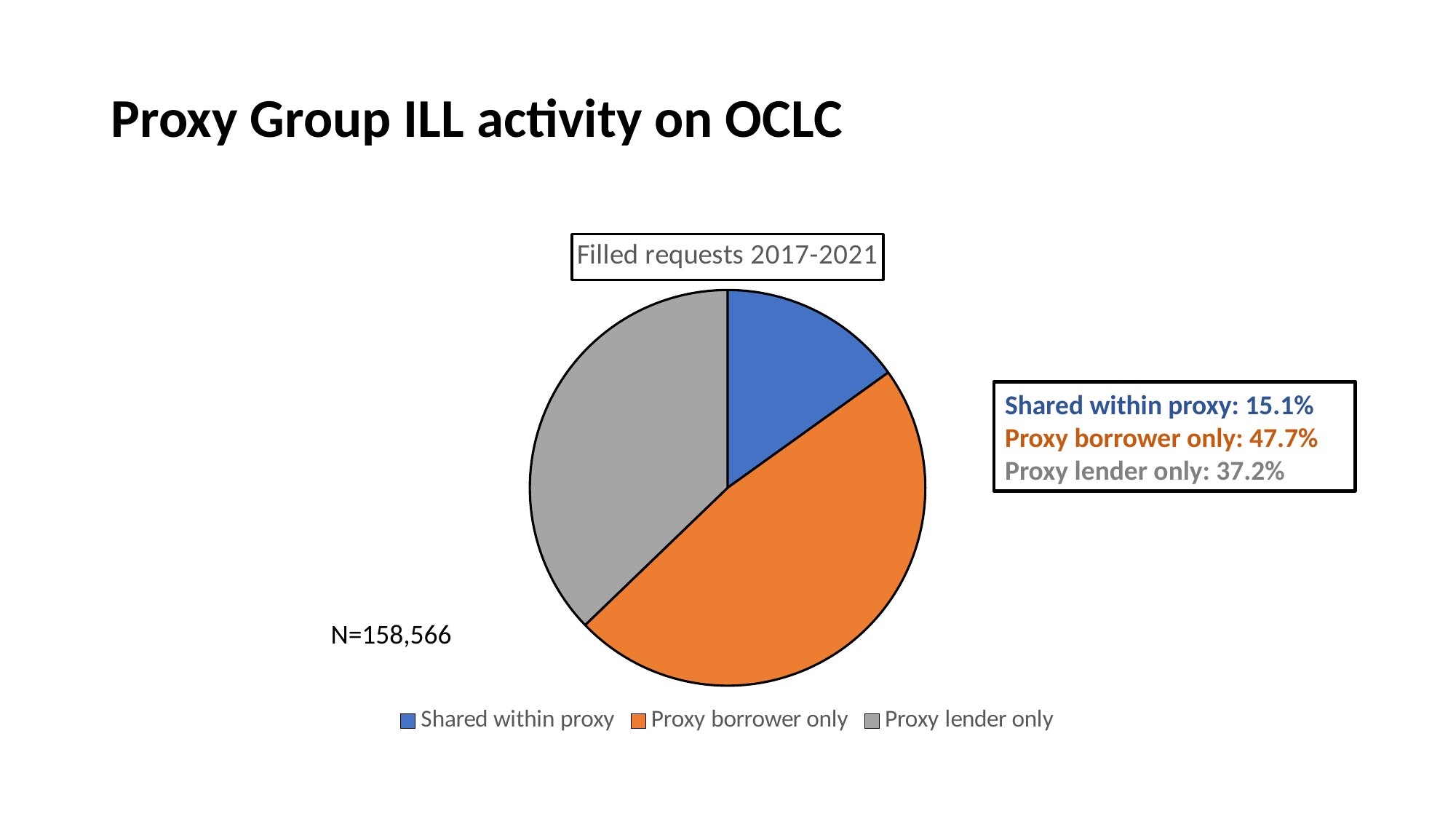
Which category has the largest share of the pie? Proxy borrower only What is the difference in percentage points between 'Proxy borrower only' and 'Proxy lender only'? 10.5 What share of filled requests is 'Proxy lender only'? 37.2% What kind of chart is shown on the slide? Pie chart What share of filled requests is 'Proxy borrower only'? 47.7% Which colour represents 'Proxy lender only' in the pie chart? Grey Which category has the smallest share of the pie? Shared within proxy What is the total number of filled requests (N) shown on the slide? 158,566 What share of filled requests is 'Shared within proxy'? 15.1% What is the title of the chart? Filled requests 2017-2021 How many categories does the pie chart have? 3 Which is larger: the share for 'Proxy lender only' or 'Shared within proxy'? Proxy lender only